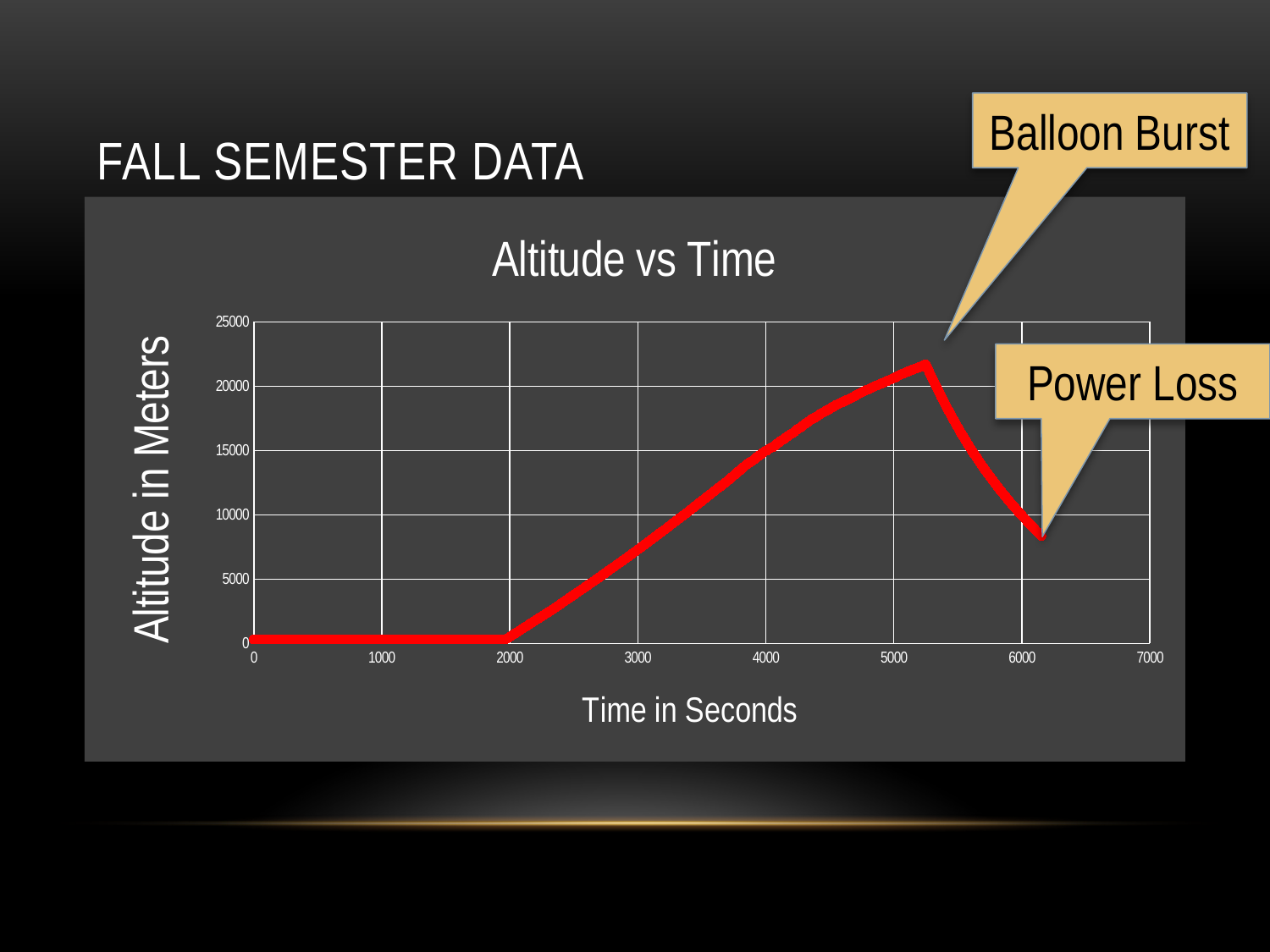
What kind of chart is shown on the slide? line chart Is the altitude at 1000 seconds greater or less than 5000 meters? less Is the peak altitude reached at the Balloon Burst greater or less than 25000 meters? less At which labelled event does the altitude reach its highest point? Balloon Burst Is the altitude at the Power Loss point greater or less than 10000 meters? less Between 2000 and 5000 seconds, does the altitude rise or fall? rise What is the label of the vertical axis? Altitude in Meters What is the title of the chart? Altitude vs Time After the Balloon Burst, does the altitude rise or fall? fall